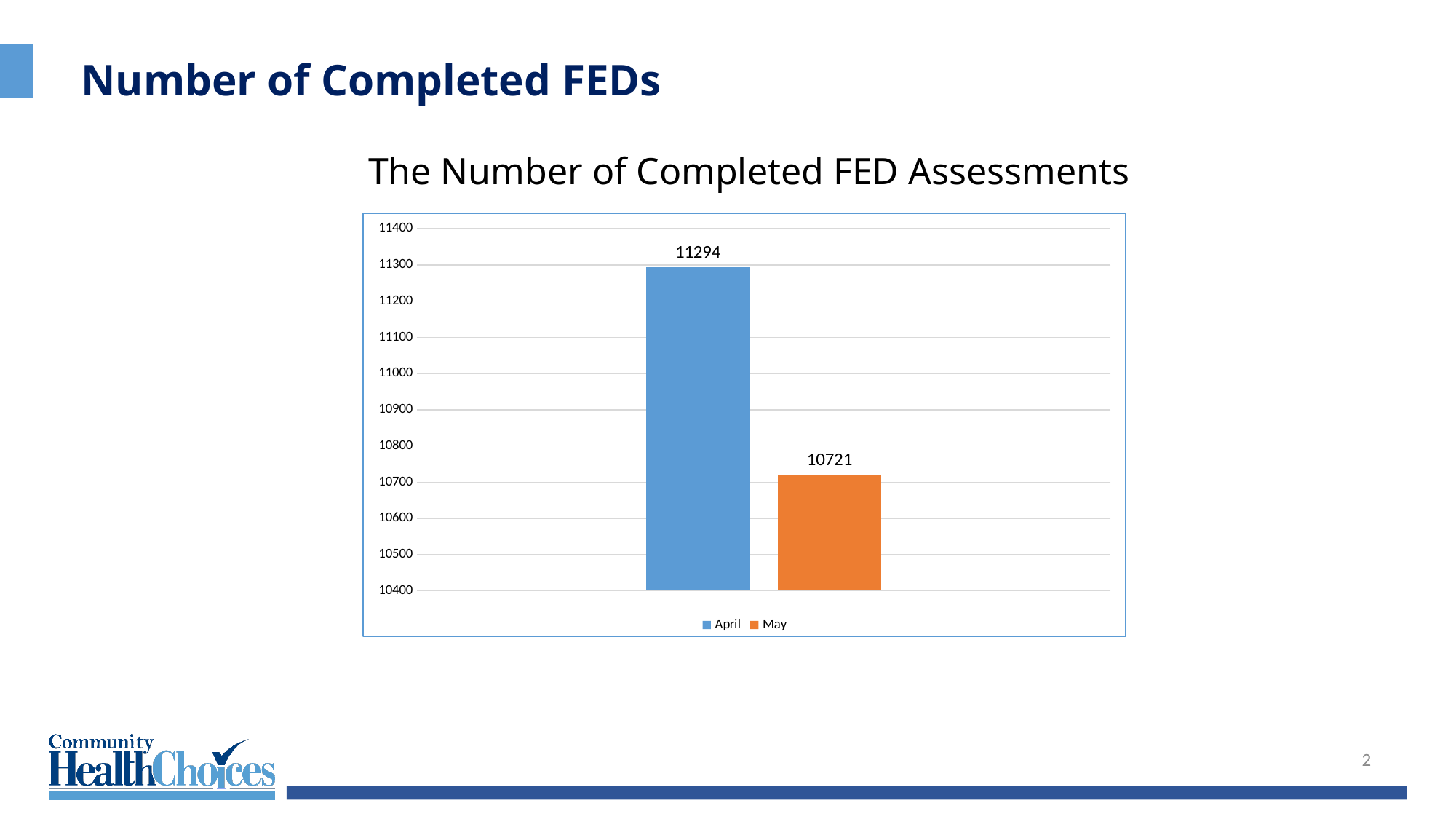
Is the value for April greater or less than 11000? greater Is the value for May greater or less than 10800? less Which month has the higher number of completed FED assessments? April What colour is the bar for May? Orange What is the difference between the April and May values? 573 Do the values rise or fall from April to May? Fall What is the title of the chart? The Number of Completed FED Assessments What is the number of completed FED assessments for April? 11294 What kind of chart is shown on the slide? Bar chart What is the number of completed FED assessments for May? 10721 Which month has the lower number of completed FED assessments? May How many series does the legend list? 2